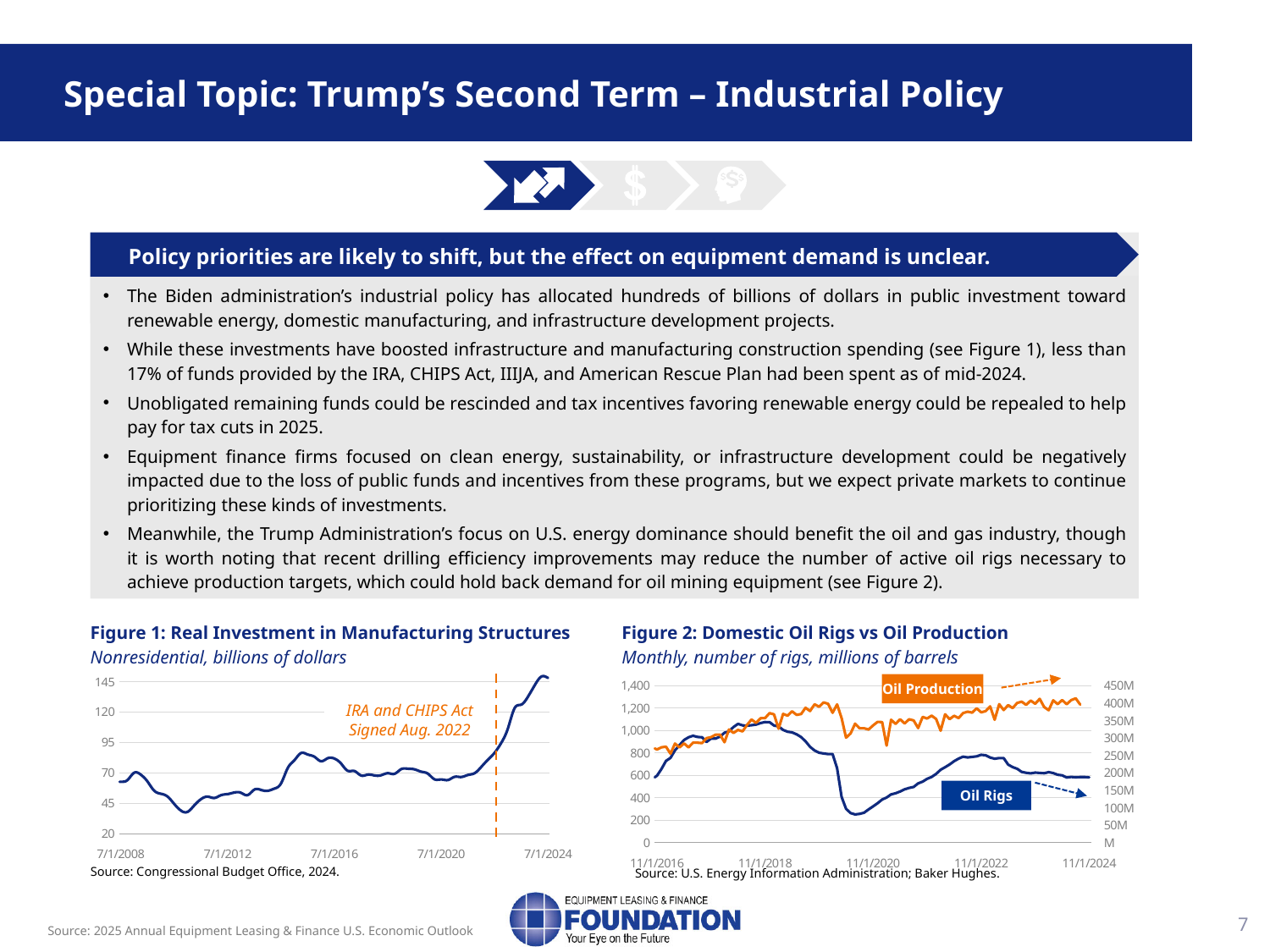
In Figure 2: Domestic Oil Rigs vs Oil Production, is the peak of the Oil Rigs line (around late 2018) greater or less than 1,000? greater In Figure 2: Domestic Oil Rigs vs Oil Production, does Oil Production generally rise or fall from 11/1/2016 to 11/1/2024? rise What kind of chart is Figure 2: Domestic Oil Rigs vs Oil Production? line chart In Figure 2: Domestic Oil Rigs vs Oil Production, how many series are plotted? 2 In Figure 1: Real Investment in Manufacturing Structures, what event does the dashed vertical line mark? IRA and CHIPS Act Signed Aug. 2022 In Figure 1: Real Investment in Manufacturing Structures, does the line rise or fall between 7/1/2020 and 7/1/2024? rise In Figure 2: Domestic Oil Rigs vs Oil Production, what are the names of the two plotted series? Oil Production and Oil Rigs In Figure 2: Domestic Oil Rigs vs Oil Production, is the lowest point of the Oil Rigs line (in 2020) greater or less than 400? less In Figure 1: Real Investment in Manufacturing Structures, is the lowest point of the line (around 2010) greater or less than 45? less What kind of chart is Figure 1: Real Investment in Manufacturing Structures? line chart